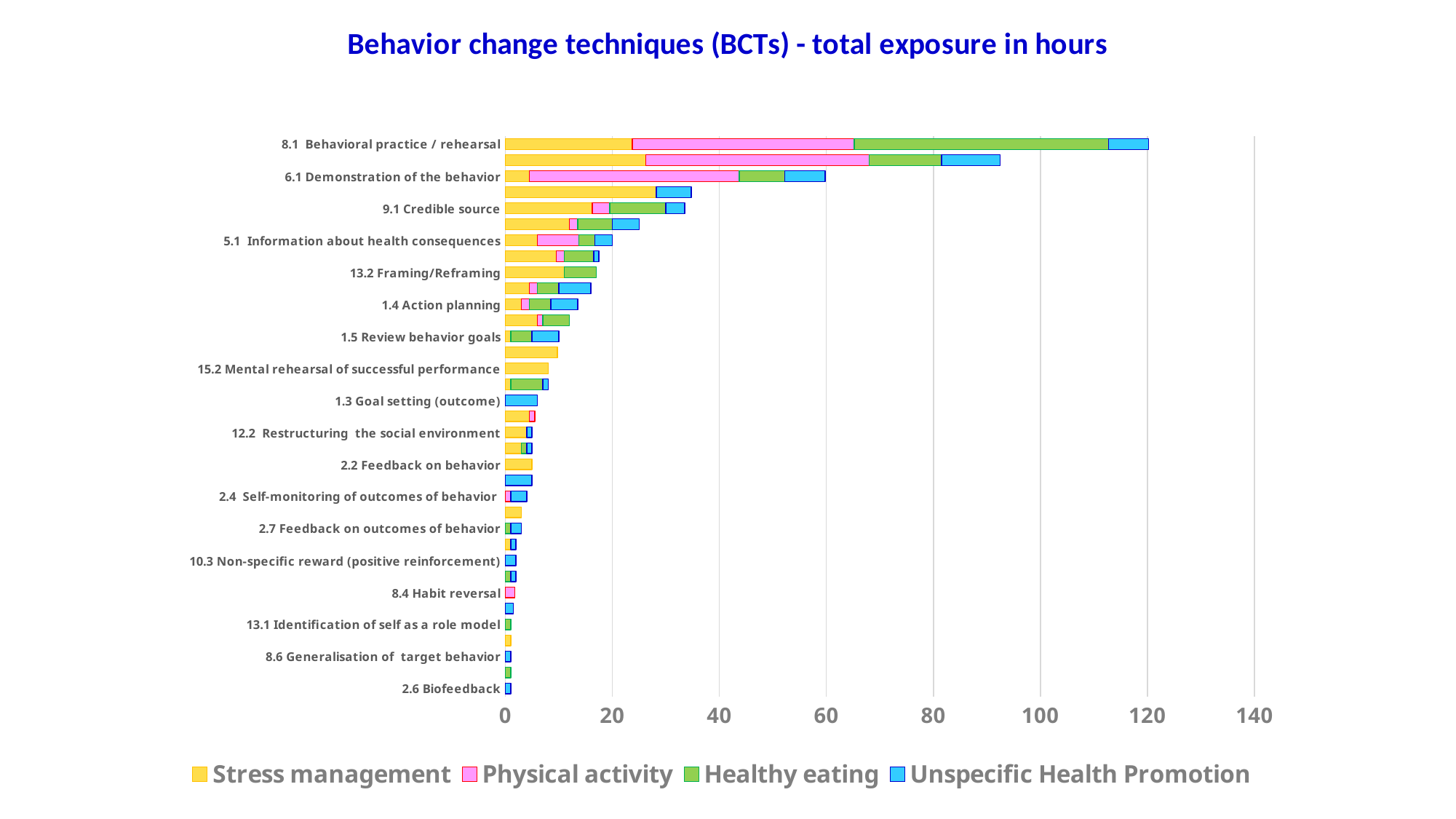
What kind of chart is shown on the slide? Stacked horizontal bar chart What is the title of the chart? Behavior change techniques (BCTs) - total exposure in hours Which series is shown in yellow in the legend? Stress management Is the total exposure for 13.2 Framing/Reframing greater or less than 20 hours? less Is the total exposure for 8.1 Behavioral practice / rehearsal greater or less than 100 hours? greater Is the total exposure for 6.1 Demonstration of the behavior greater or less than 40 hours? greater Which behavior change technique has the highest total exposure in hours? 8.1 Behavioral practice / rehearsal Which has a larger total exposure: 6.1 Demonstration of the behavior or 9.1 Credible source? 6.1 Demonstration of the behavior How many series does the legend list? 4